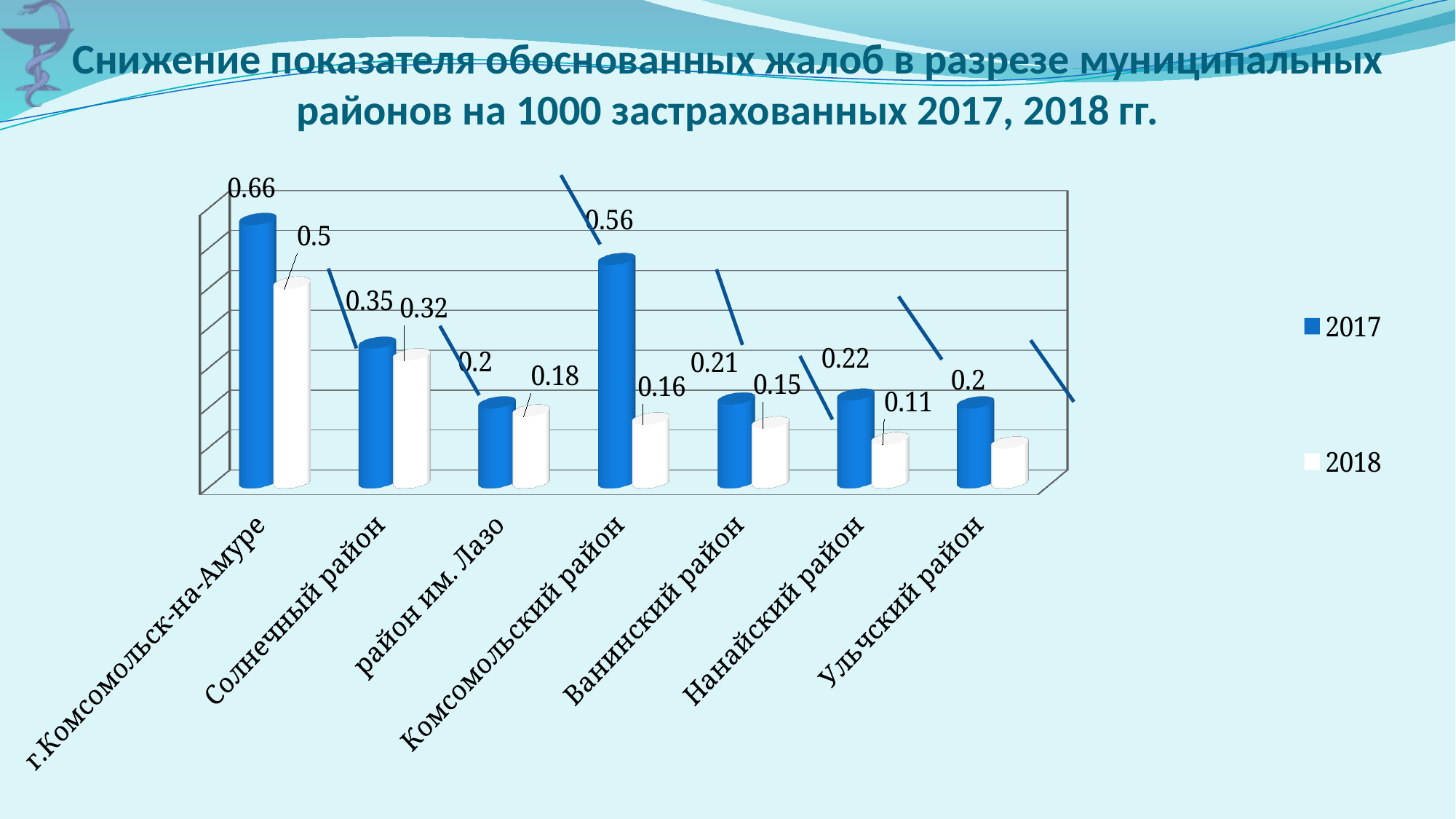
What kind of chart is shown on the slide? Bar chart Which district had the highest value in 2017? г.Комсомольск-на-Амуре Which years are listed in the legend? 2017 and 2018 Which is larger: the 2017 value for Ванинский район or the 2017 value for Нанайский район? Нанайский район How many series does the legend list? 2 How many districts are shown on the x axis? 7 What was the value for г.Комсомольск-на-Амуре in 2017? 0.66 What was the value for Нанайский район in 2017? 0.22 What was the value for Комсомольский район in 2018? 0.16 What is the difference between the 2017 and 2018 values for Комсомольский район? 0.4 Which district had the lowest value in 2018 among the labelled values? Нанайский район What was the value for Солнечный район in 2018? 0.32